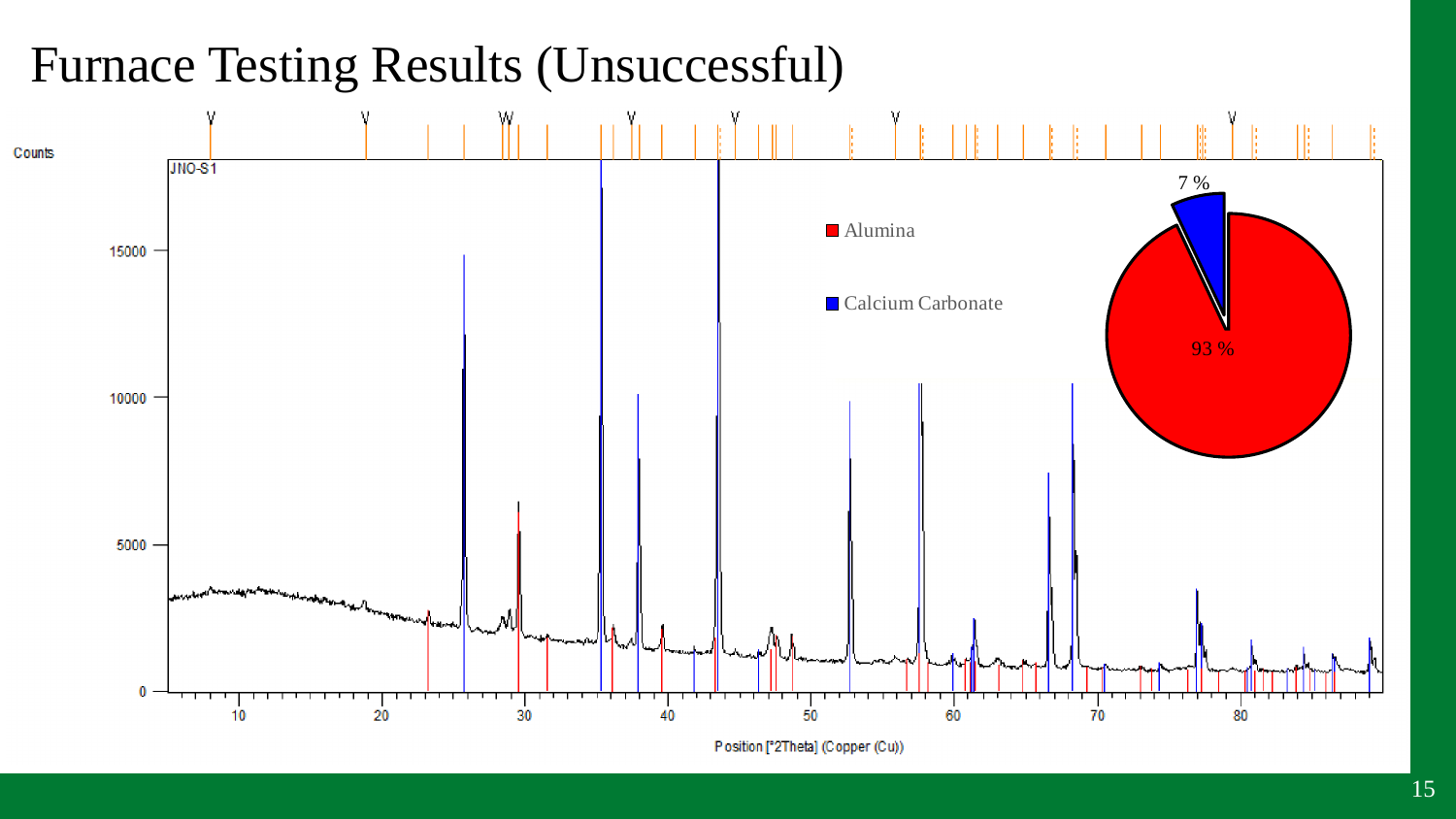
What is the title of the slide? Furnace Testing Results (Unsuccessful) In the pie chart, what share is labelled for Calcium Carbonate? 7 % In the pie chart, what share is labelled for Alumina? 93 % In the large chart on the left, is the value of the black trace at position 10 greater or less than 5000 counts? less How many entries does the pie chart legend list? 2 What is the x-axis label of the large chart on the left? Position [°2Theta] (Copper (Cu)) What kind of chart is the large chart on the left of the slide? Line chart How many slices does the pie chart have? 2 In the pie chart, what colour is the Calcium Carbonate slice? Blue In the pie chart, which component has the larger share, Alumina or Calcium Carbonate? Alumina In the pie chart, what is the difference in percentage points between the Alumina and Calcium Carbonate shares? 86 In the pie chart, which component has the smallest share? Calcium Carbonate